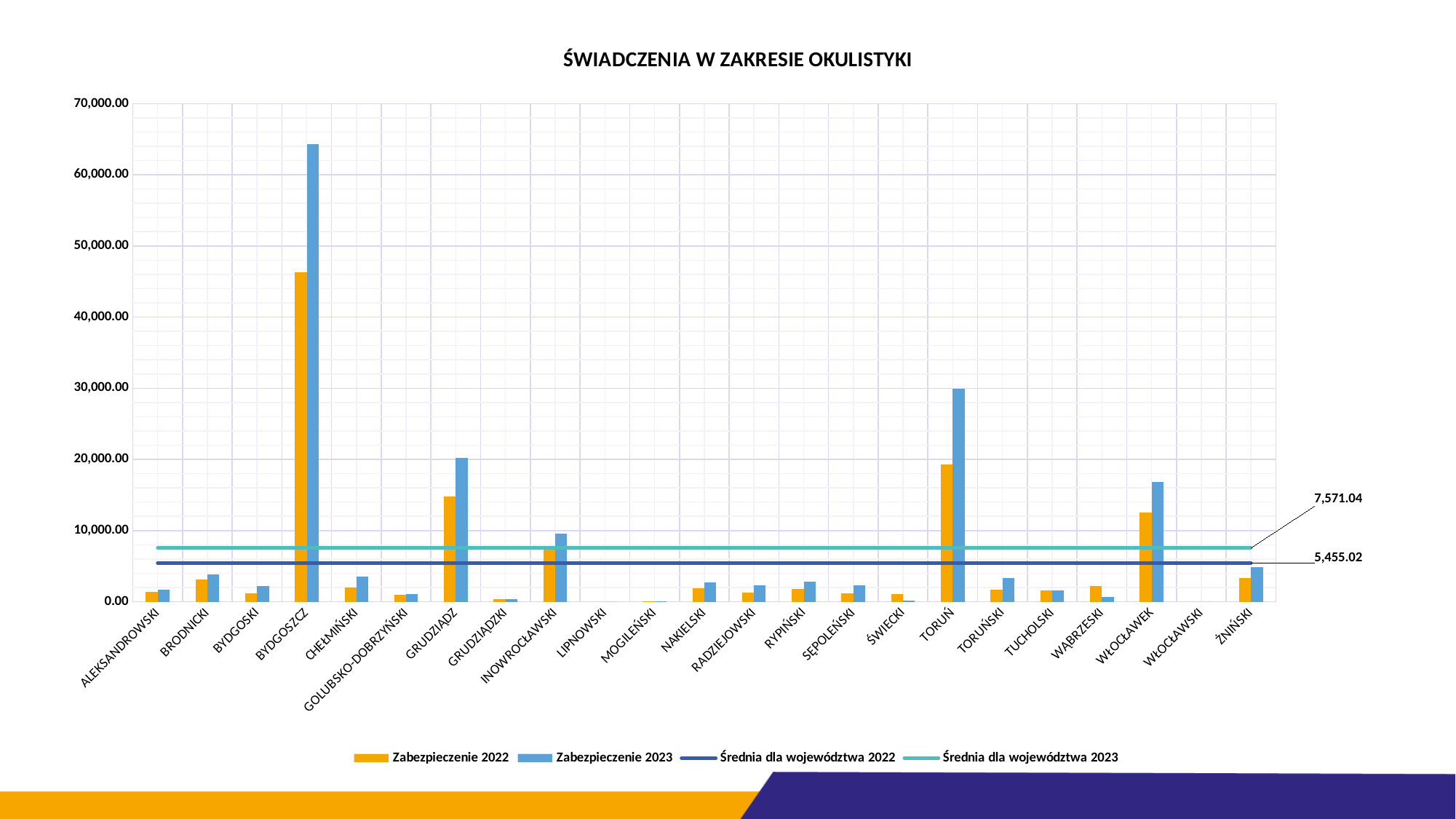
Is the Zabezpieczenie 2023 value for BYDGOSZCZ greater or less than 60,000.00? greater Which is larger for TORUŃ: Zabezpieczenie 2022 or Zabezpieczenie 2023? Zabezpieczenie 2023 How many categories are shown on the x axis? 23 What is the title of the chart? ŚWIADCZENIA W ZAKRESIE OKULISTYKI Which category has the highest Zabezpieczenie 2023 value? BYDGOSZCZ How many series does the legend list? 4 What is the value of Średnia dla województwa 2023? 7,571.04 What is the difference between Średnia dla województwa 2023 and Średnia dla województwa 2022? 2,116.02 Is the Zabezpieczenie 2022 value for GRUDZIĄDZ greater or less than 10,000.00? greater Which has the larger Zabezpieczenie 2023 value: TORUŃ or GRUDZIĄDZ? TORUŃ What kind of chart is shown on the slide? combination bar and line chart What is the value of Średnia dla województwa 2022? 5,455.02